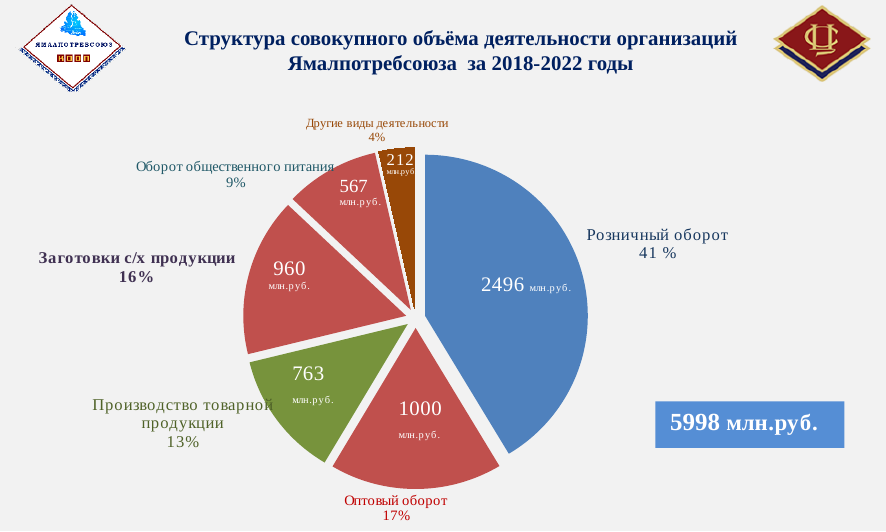
Какая доля приходится на «Оптовый оборот»? 17% Какое значение указано для сектора «Заготовки с/х продукции»? 960 млн.руб. Какое значение указано для сектора «Производство товарной продукции»? 763 млн.руб. Какой вид деятельности имеет наименьшую долю в совокупном объёме? Другие виды деятельности Какой вид деятельности имеет наибольшую долю в совокупном объёме? Розничный оборот Какой тип диаграммы показан на слайде? Круговая диаграмма Что больше: заготовки с/х продукции или производство товарной продукции? Заготовки с/х продукции Какое значение указано для сектора «Розничный оборот»? 2496 млн.руб. Сколько категорий (секторов) показано на круговой диаграмме? 6 Какой совокупный объём деятельности указан на слайде? 5998 млн.руб. Какая доля приходится на «Оборот общественного питания»? 9% На сколько млн.руб. розничный оборот больше оптового оборота? 1496 млн.руб.